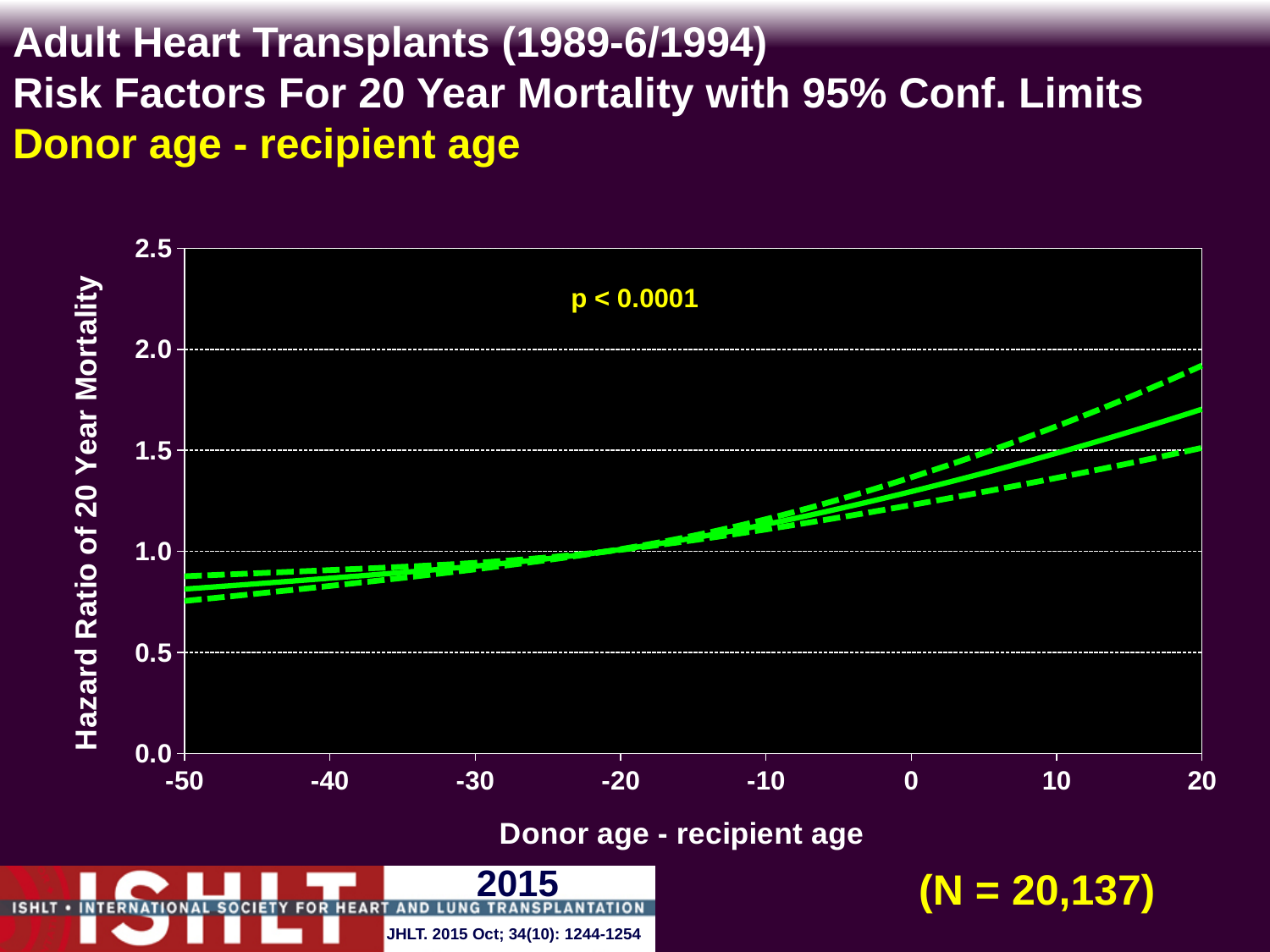
What is the label of the y axis? Hazard Ratio of 20 Year Mortality Is the hazard ratio on the solid line at a donor age - recipient age of -50 greater or less than 1.0? less Is the upper dashed confidence limit at a donor age - recipient age of 20 greater or less than 2.0? less What p-value is printed on the chart? p < 0.0001 What kind of chart is shown on the slide? line chart Is the hazard ratio on the solid line at a donor age - recipient age of -20 greater or less than 1.5? less Does the hazard ratio of 20 year mortality rise or fall as donor age - recipient age increases from -50 to 20? rise How many lines are plotted on the chart? 3